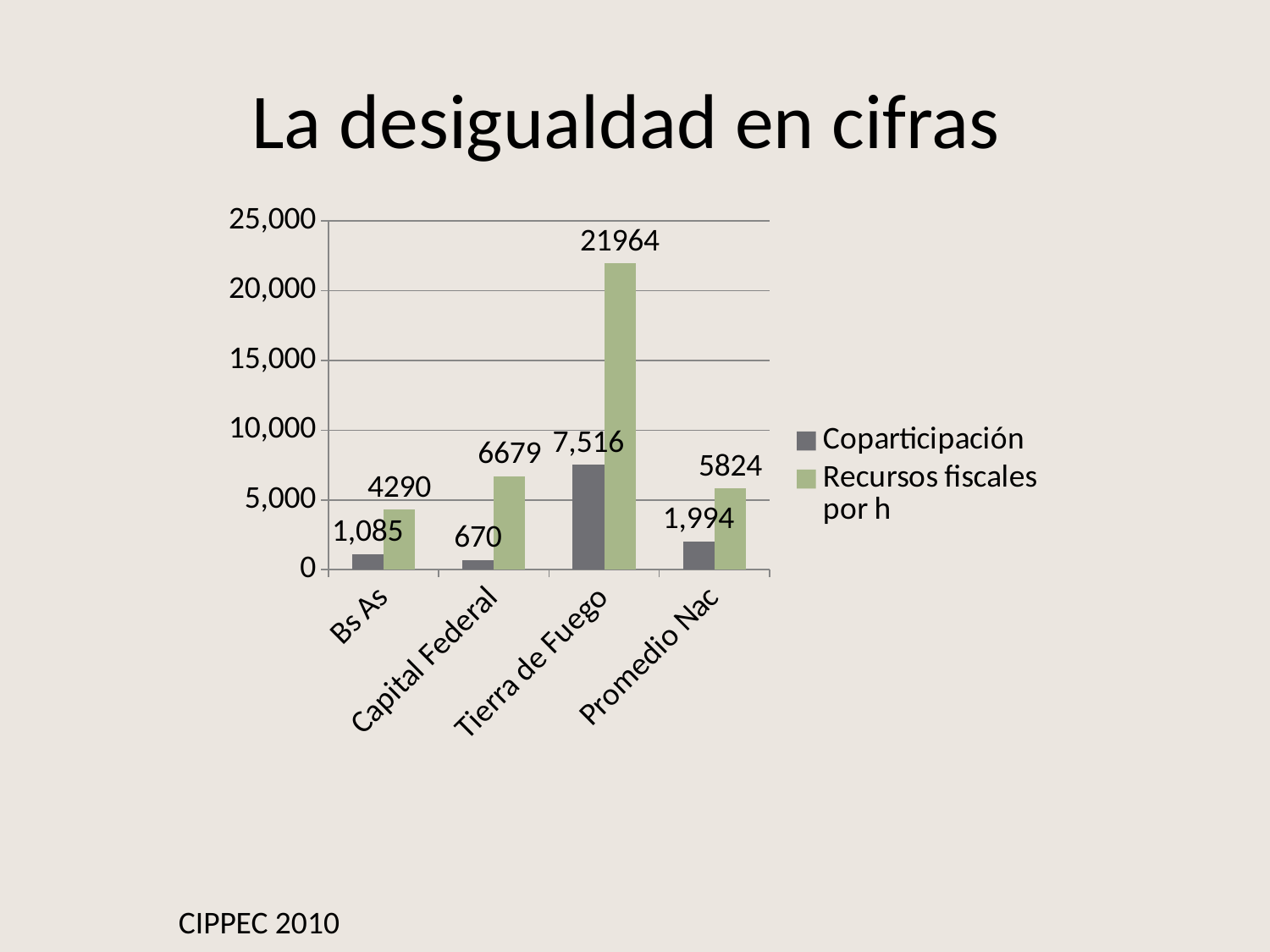
Which category has the lowest Coparticipación value? Capital Federal Which is larger: the Coparticipación value for Bs As or for Promedio Nac? Promedio Nac What is the Coparticipación value for Bs As? 1,085 What kind of chart is shown on the slide? bar chart Which category has the highest Recursos fiscales por h value? Tierra de Fuego What is the Recursos fiscales por h value for Tierra de Fuego? 21964 What is the difference between the Recursos fiscales por h values for Tierra de Fuego and Promedio Nac? 16140 How many categories are shown on the x axis? 4 Is the Recursos fiscales por h value for Capital Federal greater or less than 5,000? greater What is the Recursos fiscales por h value for Promedio Nac? 5824 What is the Coparticipación value for Capital Federal? 670 How many series does the legend list? 2